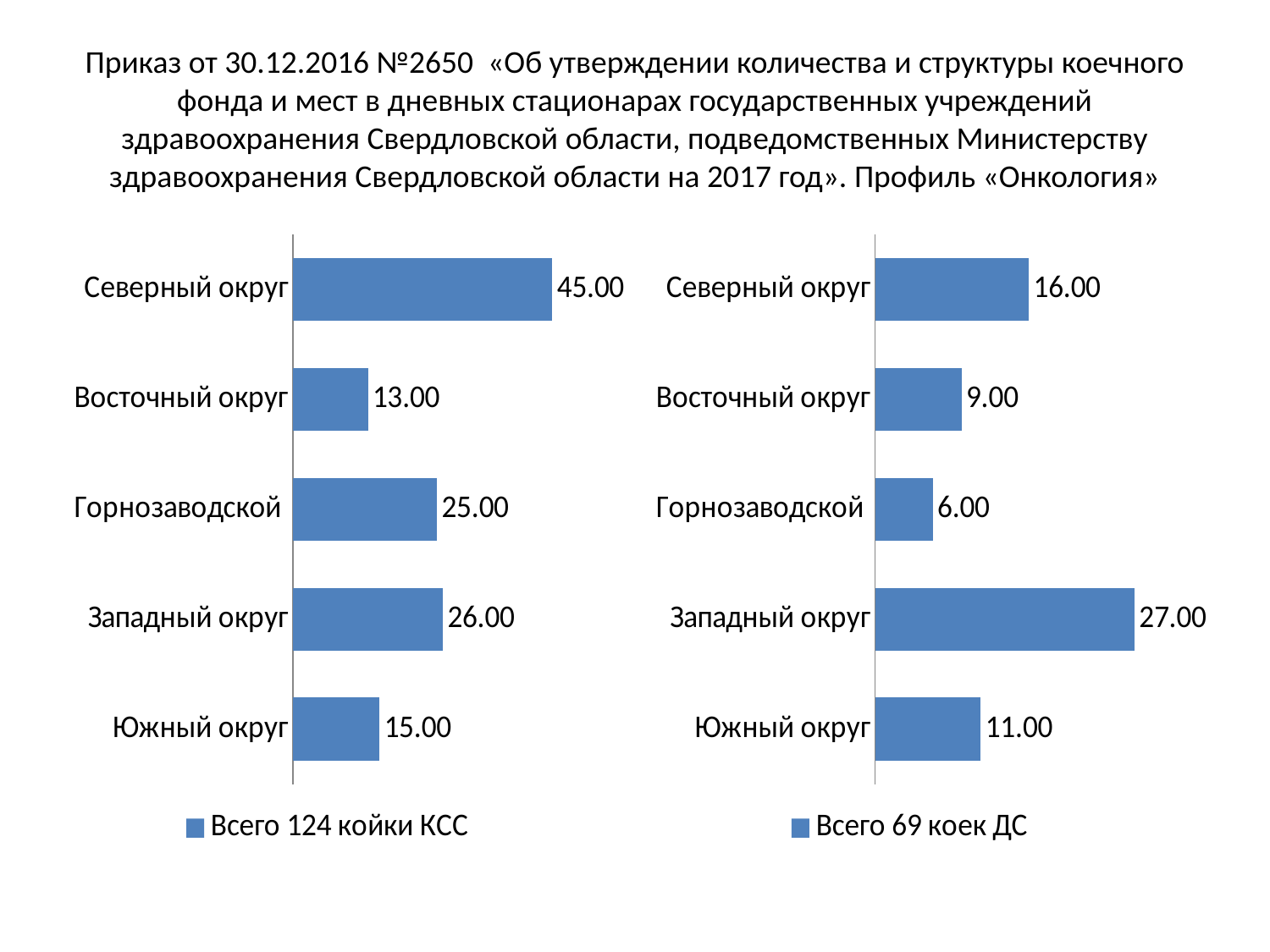
In the right chart (Всего 69 коек ДС), what is the difference between Западный округ and Северный округ? 11.00 In the right chart (Всего 69 коек ДС), what is the value for Западный округ? 27.00 In the left chart (Всего 124 койки КСС), which category has the highest value? Северный округ In the right chart (Всего 69 коек ДС), which category has the lowest value? Горнозаводской What type of chart is the left chart (Всего 124 койки КСС)? Bar chart In the left chart (Всего 124 койки КСС), which is larger: Горнозаводской or Южный округ? Горнозаводской How many categories are shown in the right chart (Всего 69 коек ДС)? 5 In the right chart (Всего 69 коек ДС), which is larger: Восточный округ or Южный округ? Южный округ What is the legend entry of the right chart? Всего 69 коек ДС In the left chart (Всего 124 койки КСС), which category has the lowest value? Восточный округ In the left chart (Всего 124 койки КСС), what is the difference between Северный округ and Южный округ? 30.00 In the left chart (Всего 124 койки КСС), what is the value for Северный округ? 45.00